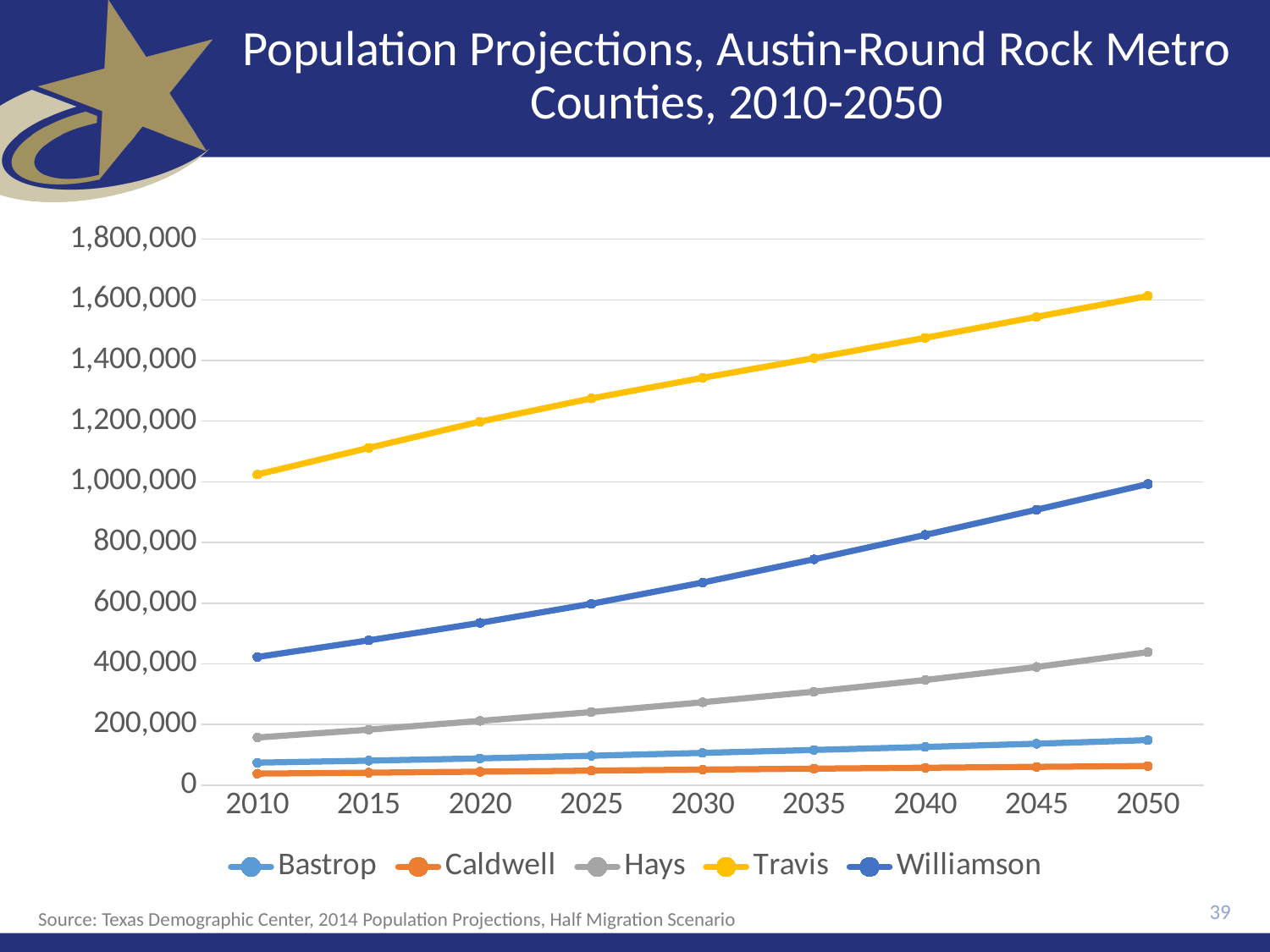
Is the value for Travis in 2050 greater or less than 1,400,000? greater How many series does the legend list? 5 How many years are plotted along the x axis? 9 What kind of chart is shown on the slide? line chart What colour is the line for Travis? yellow In 2050, which is larger, the value for Williamson or the value for Hays? Williamson Which county has the lowest projected population in 2050? Caldwell Is the value for Bastrop in 2050 greater or less than 200,000? less Which county has the highest projected population in 2050? Travis Is the value for Williamson in 2050 greater or less than 800,000? greater Does the projected population for Travis rise or fall from 2010 to 2050? rise